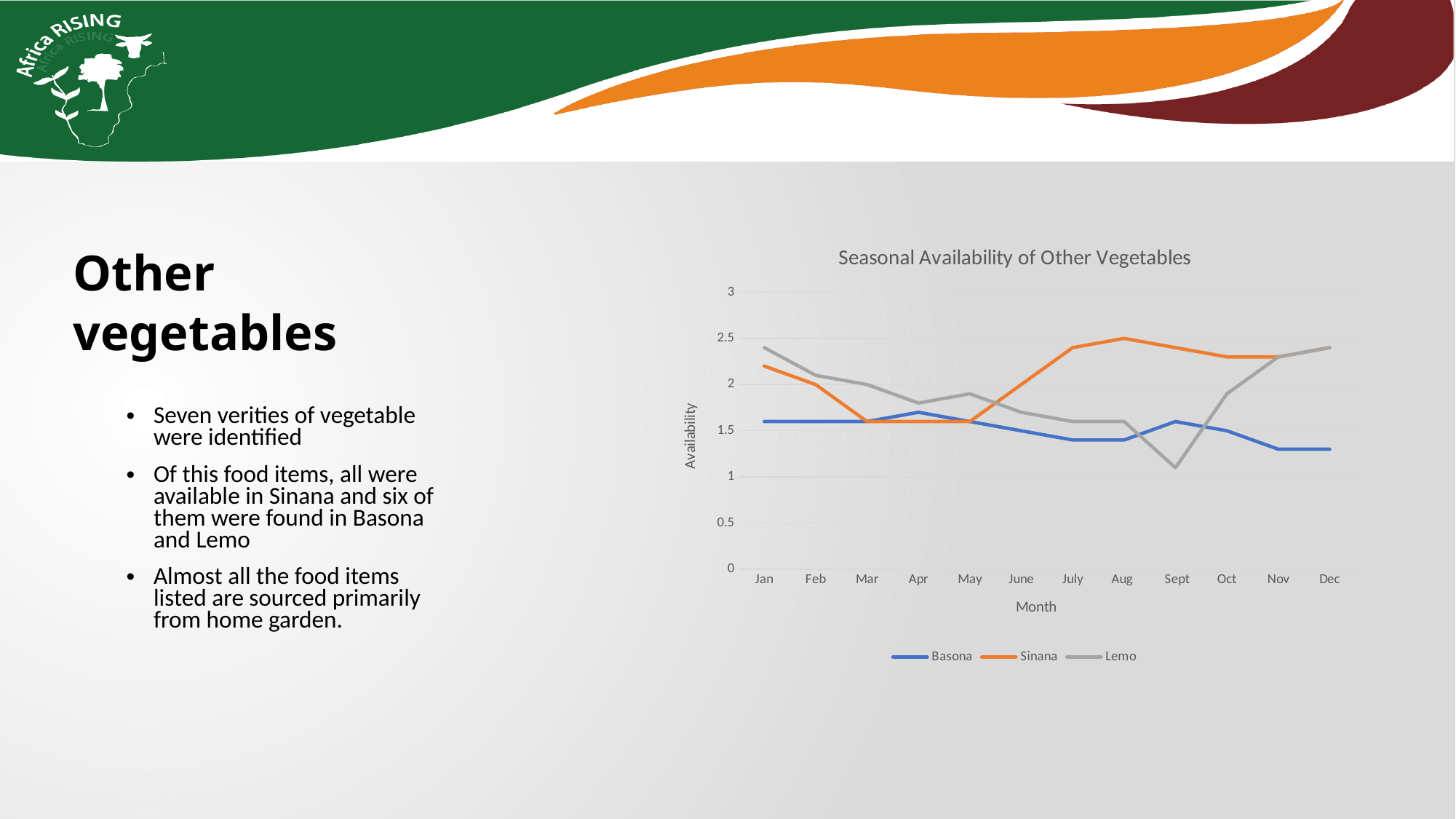
In Aug, which is larger, the value for Sinana or the value for Basona? Sinana Is the value for Basona in Dec greater or less than 1.5? less What is the title of the chart? Seasonal Availability of Other Vegetables How many months are plotted along the x axis? 12 How many series does the legend list? 3 Which series has the lowest value in Sept? Lemo Which series has the highest value in Sept? Sinana Is the value for Lemo in Sept greater or less than 1.5? less Is the value for Sinana in July greater or less than 2? greater What is the label on the vertical axis? Availability What kind of chart is shown on the slide? Line chart